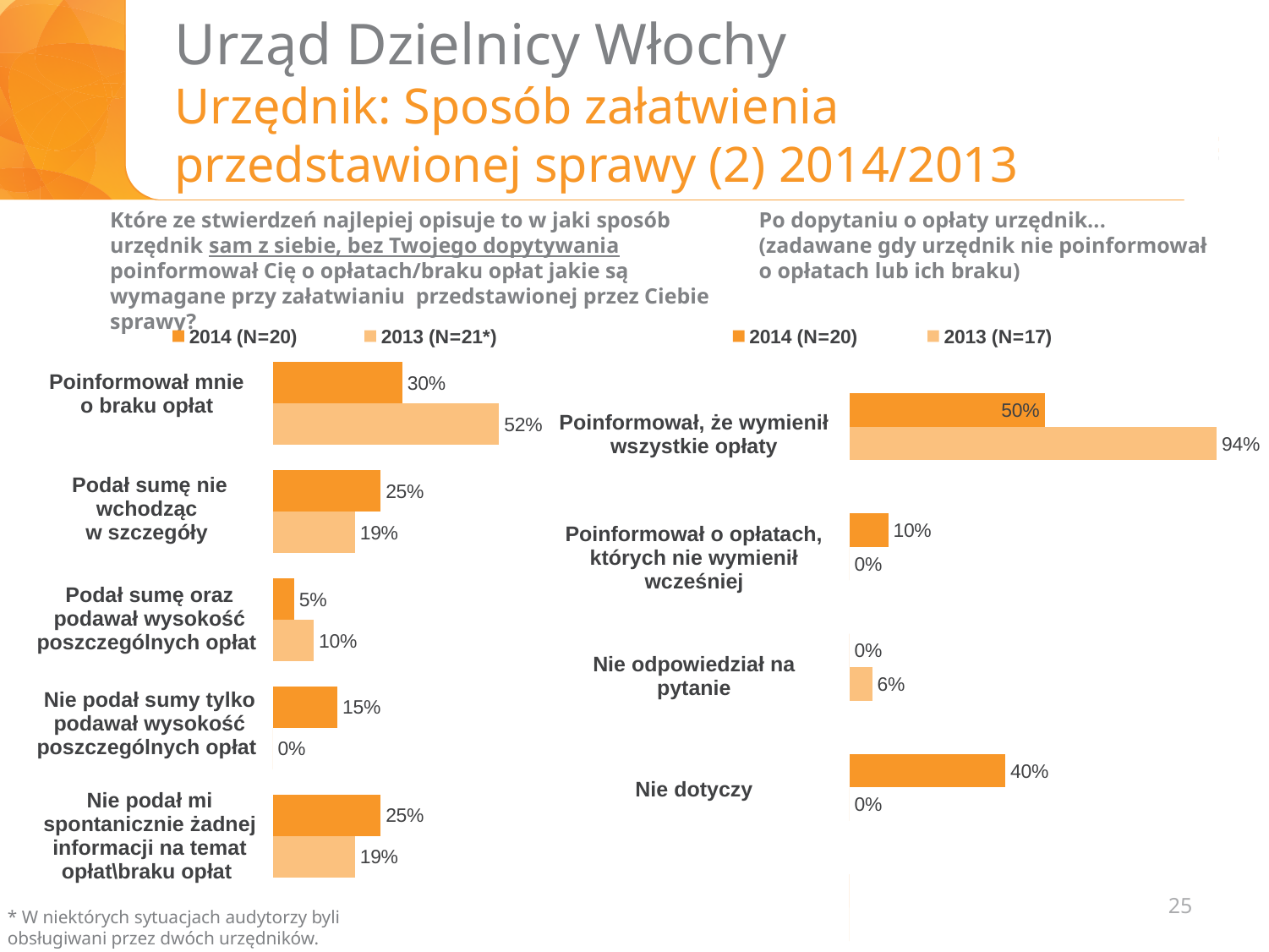
In the right chart, which is larger for "Poinformował, że wymienił wszystkie opłaty": the 2014 value or the 2013 value? 2013 In the left chart, what is the 2014 value for "Poinformował mnie o braku opłat"? 30% In the left chart, what is the 2014 value for "Nie podał sumy tylko podawał wysokość poszczególnych opłat"? 15% What type of chart is the right chart? Bar chart In the left chart, which category has the highest 2013 value? Poinformował mnie o braku opłat In the right chart, how many series does the legend list? 2 In the left chart, which category has the lowest 2014 value? Podał sumę oraz podawał wysokość poszczególnych opłat In the left chart, what is the 2013 value for "Poinformował mnie o braku opłat"? 52% In the right chart, what is the 2014 value for "Nie dotyczy"? 40% In the left chart, how many categories are shown? 5 In the left chart, what is the difference between the 2013 and 2014 values for "Poinformował mnie o braku opłat"? 22 percentage points In the right chart, what is the 2013 value for "Poinformował, że wymienił wszystkie opłaty"? 94%